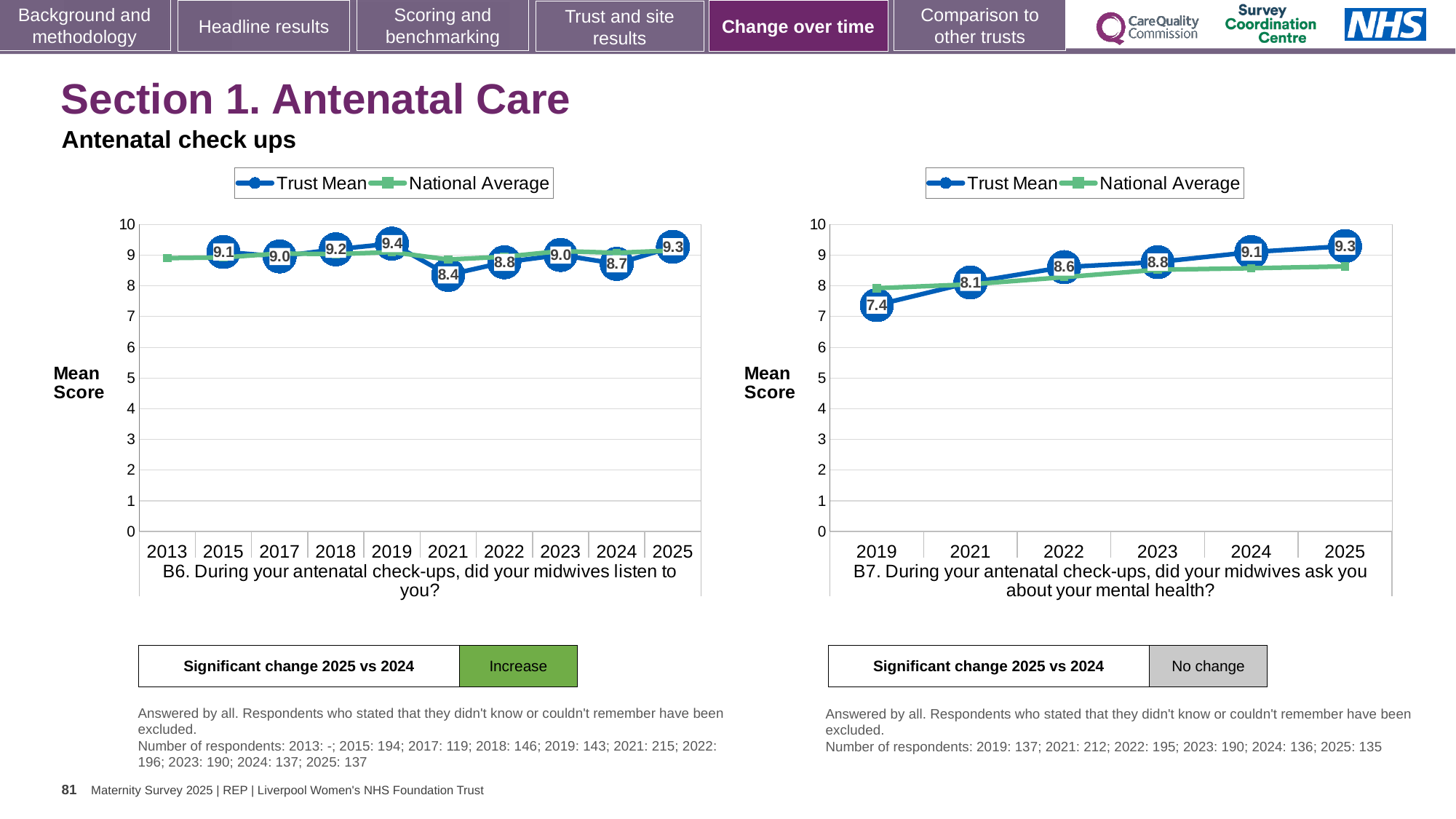
In the B7 chart (right), which year has the highest Trust Mean? 2025 In the B6 chart (left), what is the Trust Mean for 2021? 8.4 What kind of chart is the B7 chart (right)? line chart In the B6 chart (left), how many years are shown on the x axis? 10 In the B6 chart (left), what is the Trust Mean for 2019? 9.4 How many series does the legend of the B6 chart (left) list? 2 In the B7 chart (right), is the Trust Mean for 2019 greater or less than 8? less In the B7 chart (right), what is the difference between the Trust Mean for 2025 and 2019? 1.9 In the B6 chart (left), what is the difference between the Trust Mean for 2025 and 2024? 0.6 In the B7 chart (right), what is the Trust Mean for 2019? 7.4 In the B7 chart (right), does the Trust Mean rise or fall from 2019 to 2025? rise In the B6 chart (left), which year has the lowest Trust Mean? 2021